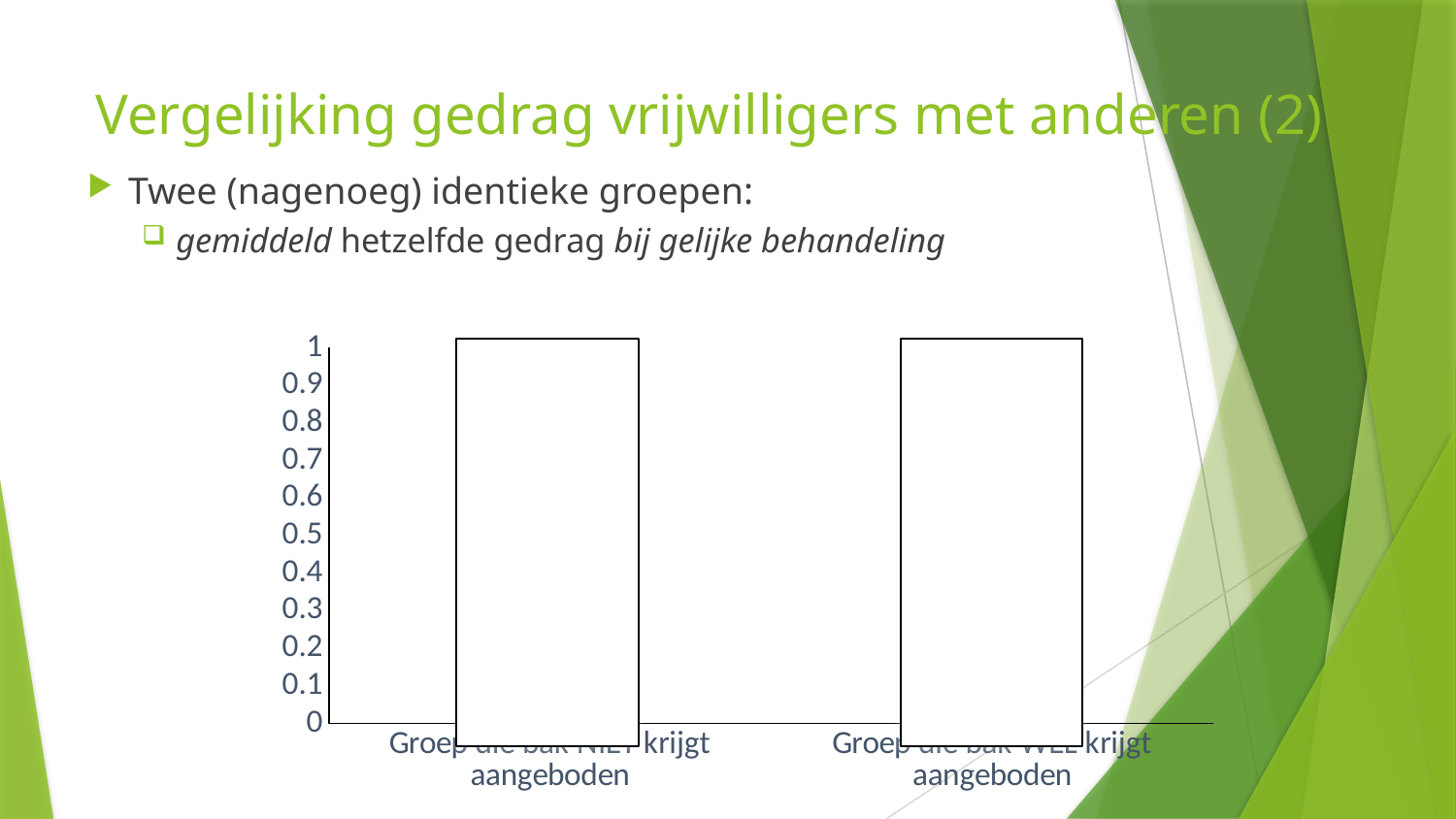
What is the highest value shown on the y axis? 1 What kind of chart is shown on the slide? bar chart What is the difference between the values for 'Groep die bak NIET krijgt aangeboden' and 'Groep die bak WEL krijgt aangeboden'? 0 Is the value for 'Groep die bak WEL krijgt aangeboden' greater or less than 0.9? greater What is the value for 'Groep die bak NIET krijgt aangeboden'? 1 What is the value for 'Groep die bak WEL krijgt aangeboden'? 1 How many bars does the chart show? 2 What is the lowest value shown on the y axis? 0 Is the value for 'Groep die bak NIET krijgt aangeboden' greater or less than 0.5? greater